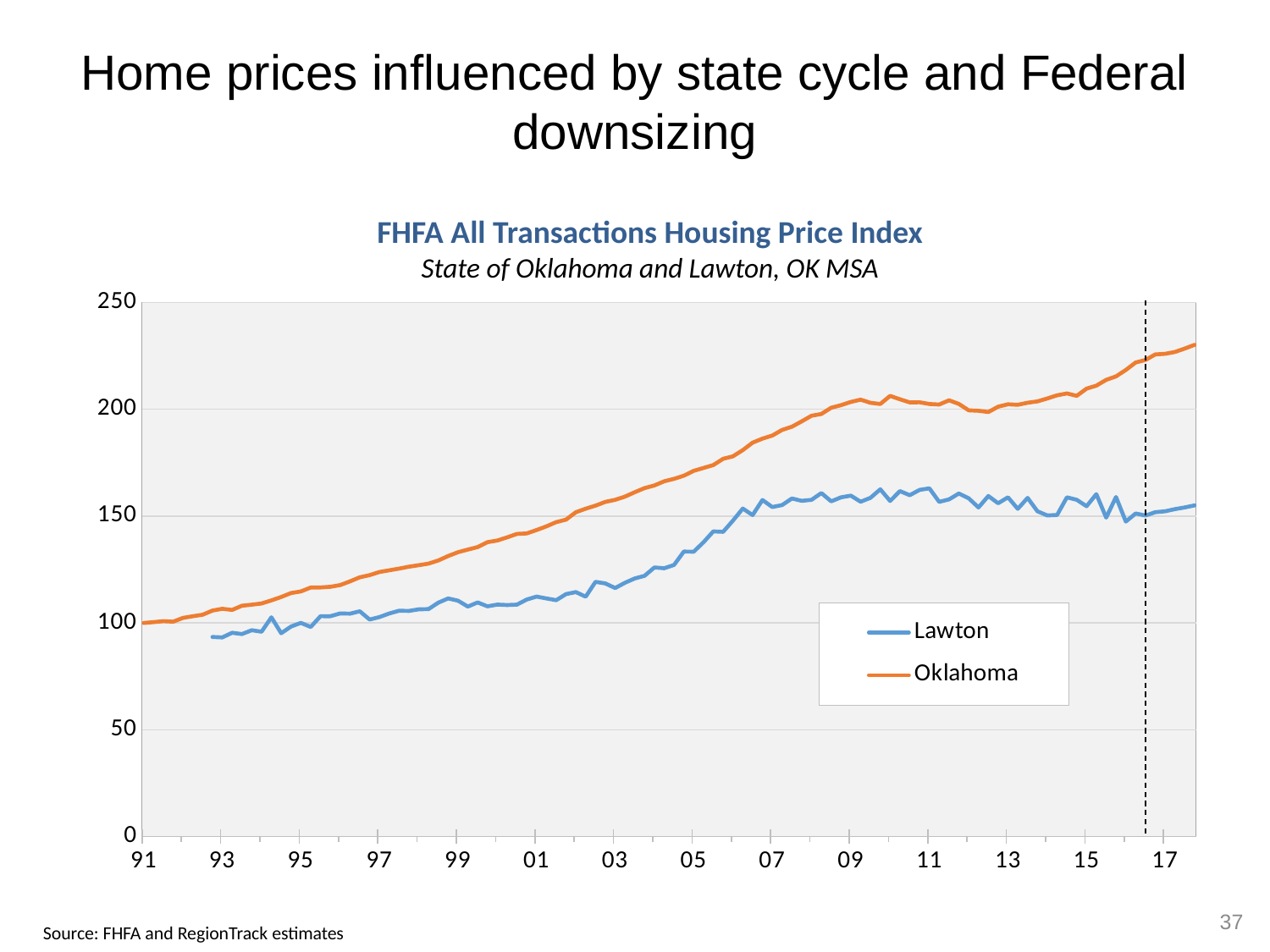
What are the two series named in the legend? Lawton and Oklahoma How many series does the legend list? 2 Is the value for Oklahoma at 17 greater or less than 200? greater Is the value for Lawton at 93 greater or less than 100? less Does the Oklahoma series generally rise or fall from 91 to 17? rise Is the value for Lawton at 05 greater or less than 150? less What kind of chart is shown on the slide? line chart Which series is higher at the right end of the chart (17), Lawton or Oklahoma? Oklahoma What is the title of the chart? FHFA All Transactions Housing Price Index Which series is higher in 09, Lawton or Oklahoma? Oklahoma